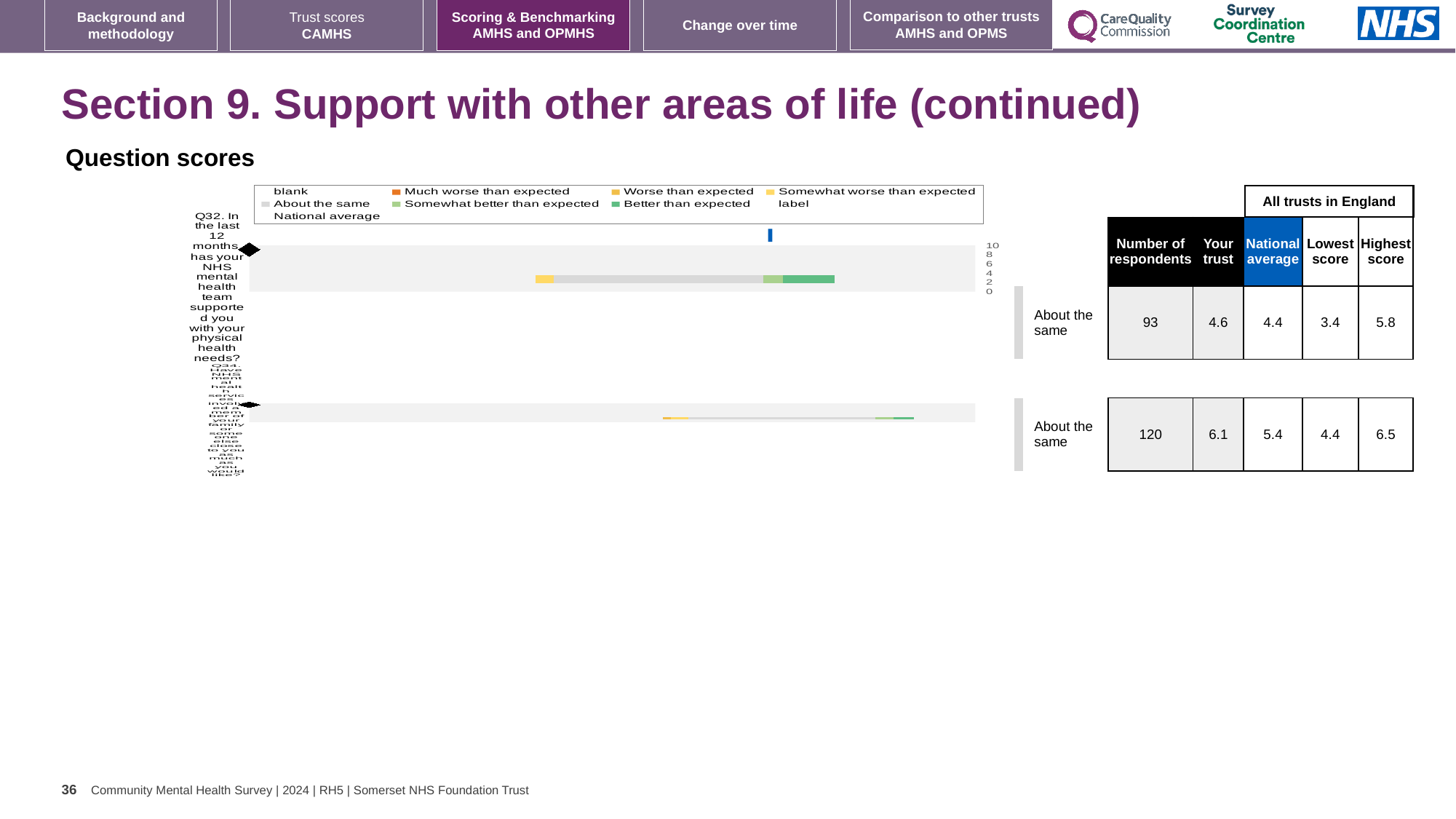
Which legend entry in the question scores chart is shown in orange? Much worse than expected In the table next to the chart, what is the national average for Q32? 4.4 What is the difference between the 'Your trust' scores for Q34 and Q32 in the table? 1.5 Which question has the higher 'Your trust' score in the table, Q32 or Q34? Q34 How many entries does the legend of the question scores chart list? 9 What kind of chart is used to show the question scores on this slide? bar chart In the table next to the chart, what is the 'Your trust' score for Q34? 6.1 In the table next to the chart, what is the number of respondents for Q32? 93 In the table next to the chart, what is the highest score across all trusts in England for Q34? 6.5 What benchmark category is given for both Q32 and Q34 next to the chart? About the same What is the highest tick value shown on the axis of the question scores chart? 10 How many questions (categories) are plotted in the question scores chart? 2